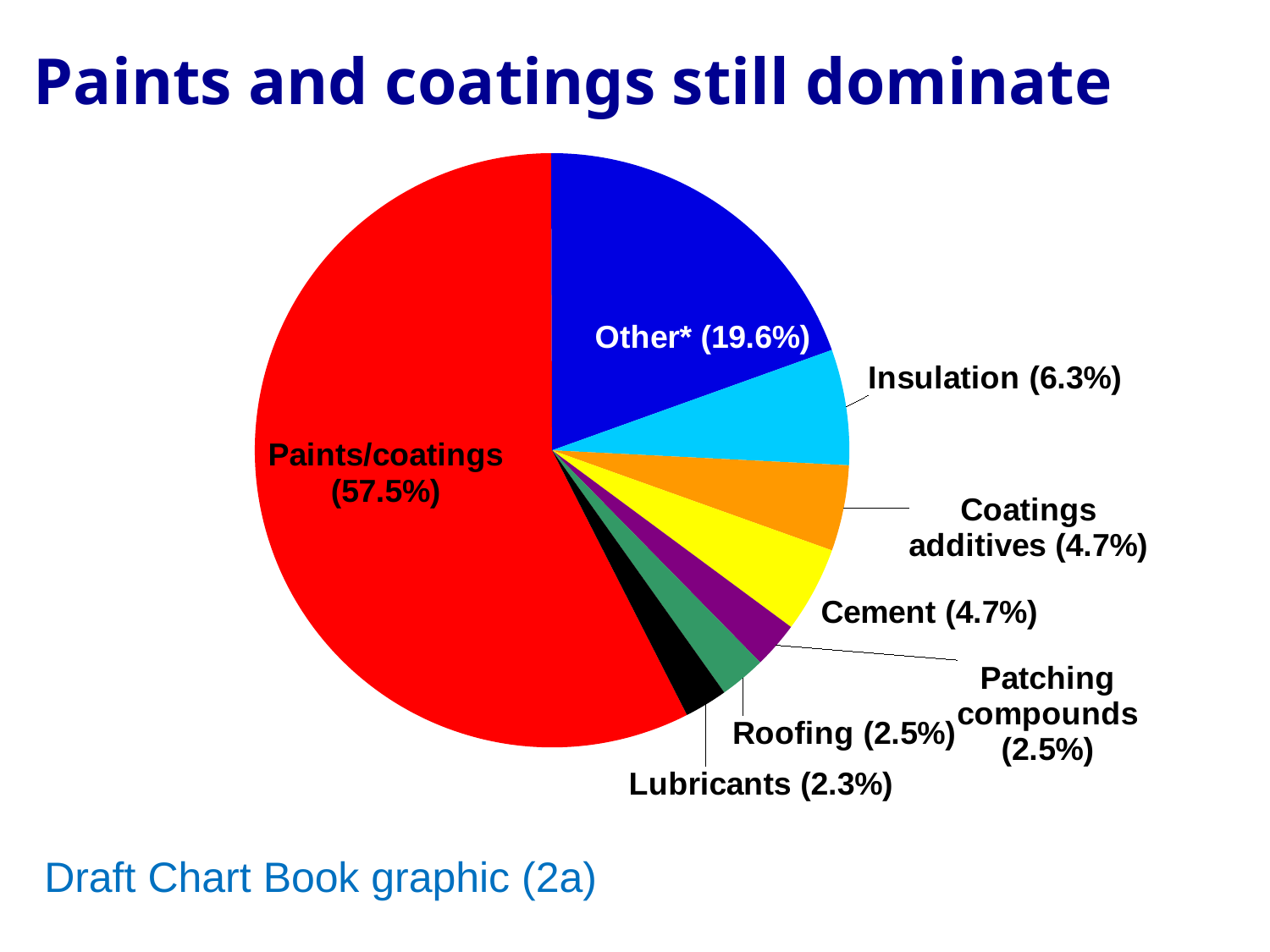
What is the difference in percentage points between Insulation and Cement? 1.6 Which category has the largest slice of the pie? Paints/coatings Which is larger, the share for Insulation or the share for Coatings additives? Insulation What is the value shown for Insulation? 6.3% How many categories are shown in the pie chart? 8 What share of the pie does Paints/coatings account for? 57.5% What colour is the Paints/coatings slice? Red What kind of chart is shown on the slide? Pie chart What is the value shown for Lubricants? 2.3% Which category has the smallest slice of the pie? Lubricants What is the value shown for Other*? 19.6% What is the difference in percentage points between Paints/coatings and Other*? 37.9